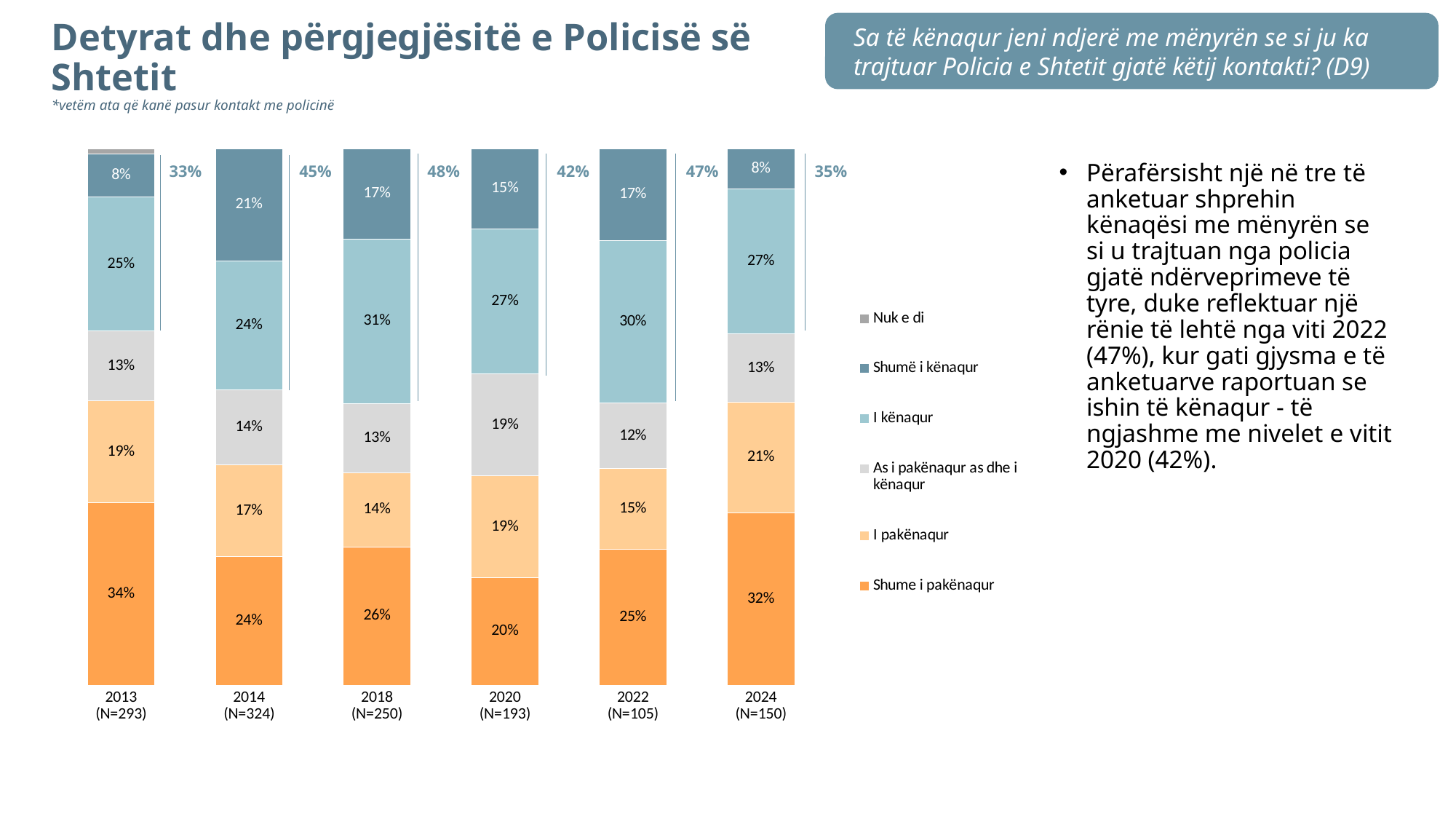
What is the difference between the 'Shume i pakënaqur' values for 2024 and 2020? 12 percentage points What is the value for 'I kënaqur' in 2018? 31% How many series does the chart's legend list? 6 What is the value for 'Shume i pakënaqur' in 2013? 34% How many years (categories) are shown on the x axis of the chart? 6 Which is larger: the 'I pakënaqur' value in 2024 or in 2022? 2024 What is the combined satisfied share (the bracket label) shown for 2022? 47% What is the value for 'Shumë i kënaqur' in 2014? 21% What is the sample size (N) shown for 2024? N=150 In which year is the 'Shumë i kënaqur' value the lowest? 2013 and 2024 (8%) In which year is the combined satisfied share (bracket label) the highest? 2018 What type of chart is shown on the slide? Stacked bar chart